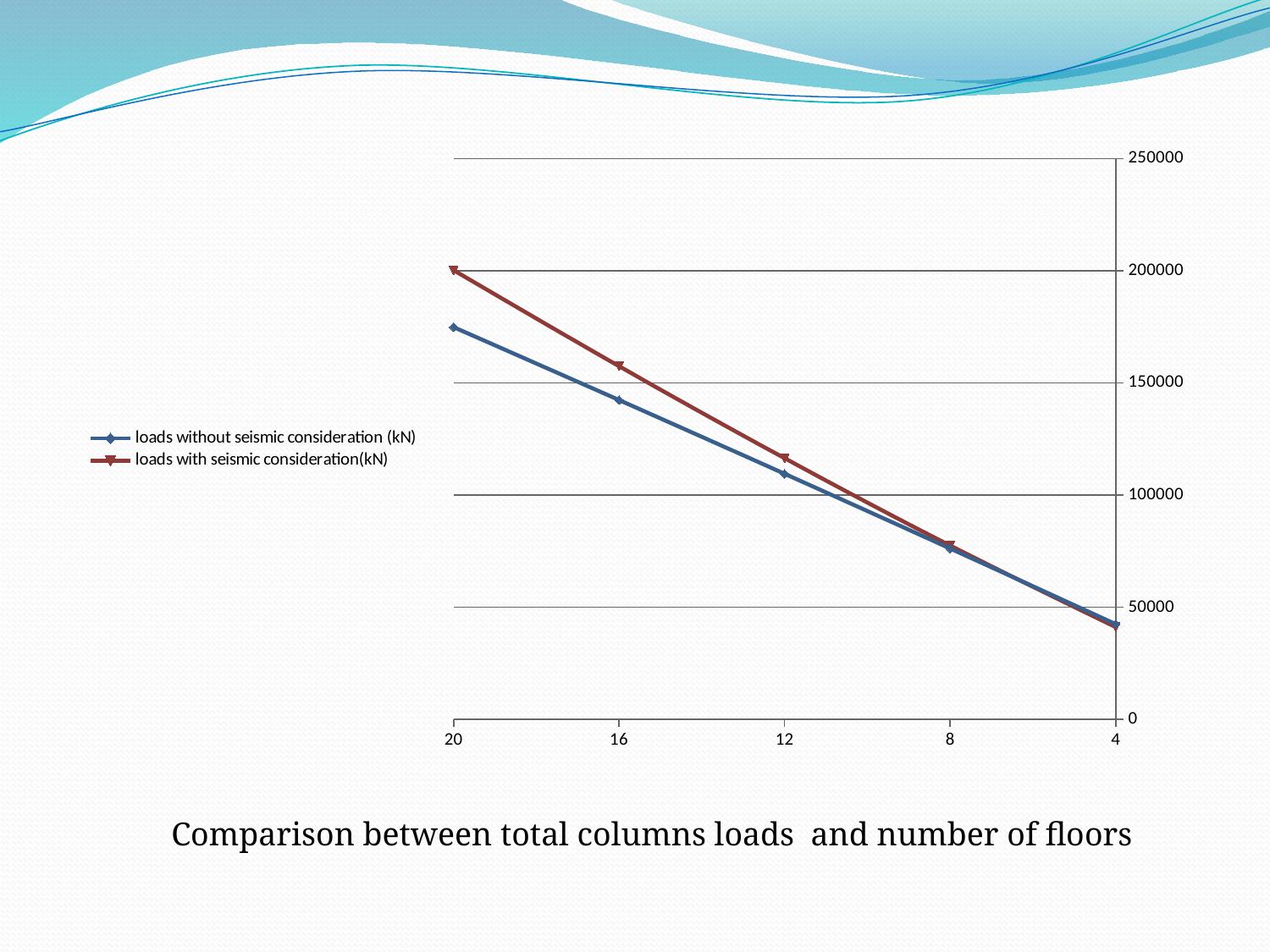
Is the value for loads without seismic consideration at 16 floors greater or less than 150000? less Do the values for loads without seismic consideration rise or fall moving from 20 floors to 4 floors along the x axis? fall Is the value for loads with seismic consideration at 12 floors greater or less than 100000? greater Is the value for loads without seismic consideration at 4 floors greater or less than 50000? less At which number of floors is the value for loads with seismic consideration highest? 20 How many points are plotted along the x axis for each series? 5 What kind of chart is shown on the slide? line chart At 20 floors, which series has the larger value: loads with seismic consideration or loads without seismic consideration? loads with seismic consideration(kN) How many series does the legend list? 2